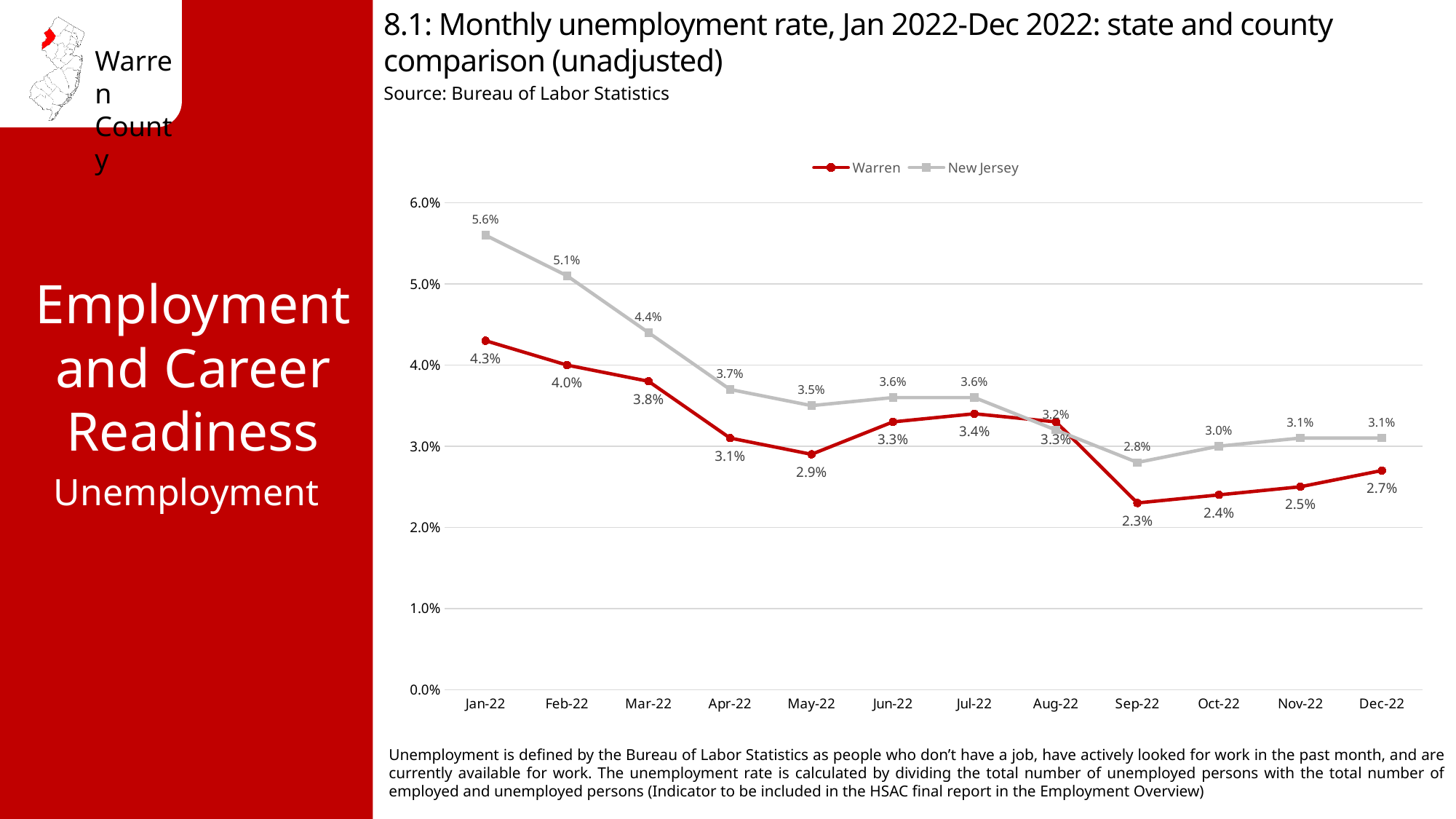
What was the unemployment rate for New Jersey in Dec-22? 3.1% What was the unemployment rate for Warren in Jan-22? 4.3% Did the New Jersey unemployment rate rise or fall from Jan-22 to Apr-22? Fall What was the unemployment rate for Warren in Sep-22? 2.3% Which series had the higher unemployment rate in Feb-22, Warren or New Jersey? New Jersey What was the unemployment rate for New Jersey in Mar-22? 4.4% How many months are plotted on the x axis? 12 What is the difference between the New Jersey and Warren unemployment rates in Jan-22? 1.3% What kind of chart is shown on the slide? Line chart In which month was the New Jersey unemployment rate highest? Jan-22 How many series does the legend list? 2 In which month was the Warren unemployment rate lowest? Sep-22